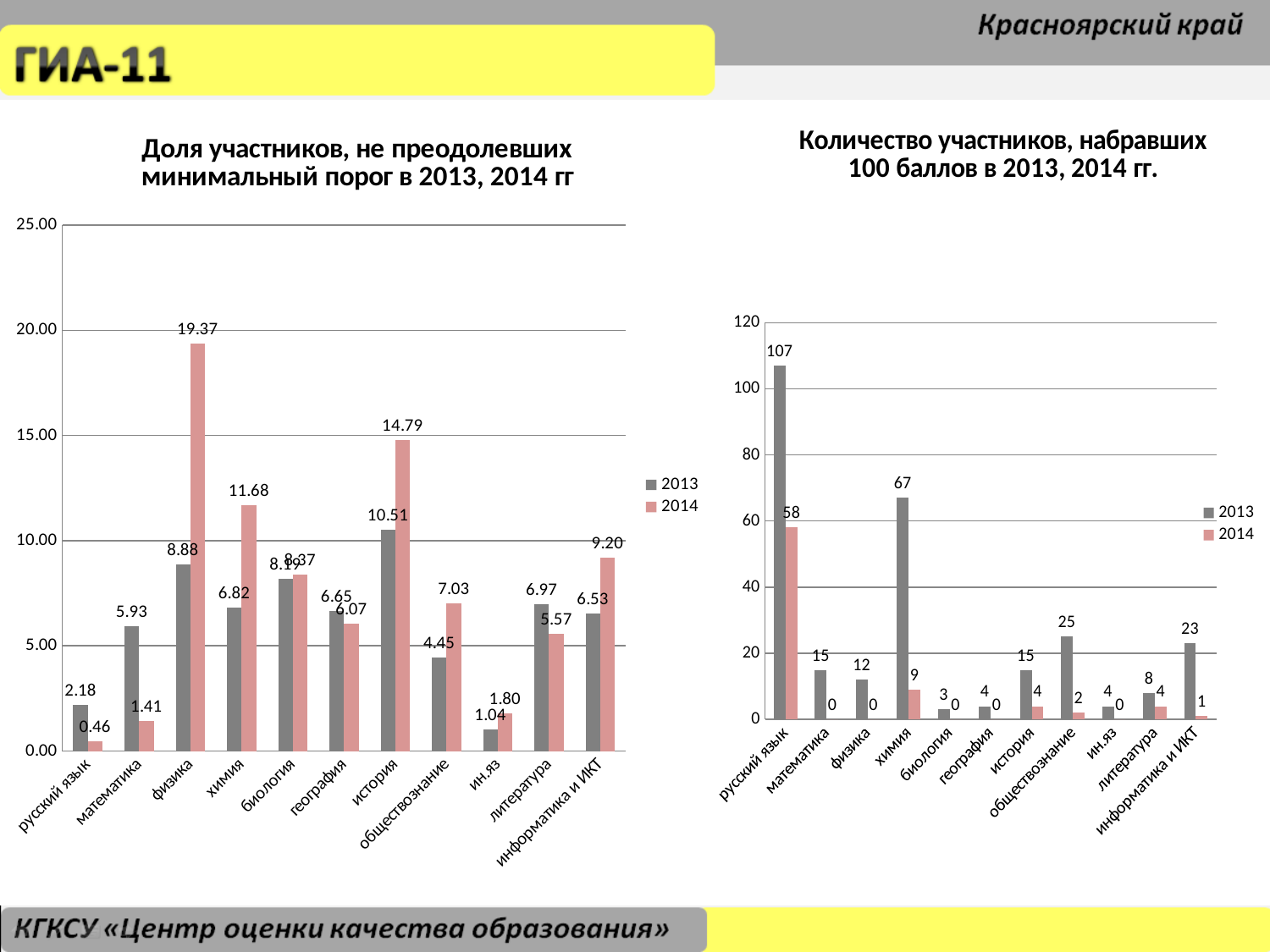
In the chart 'Доля участников, не преодолевших минимальный порог в 2013, 2014 гг', which subject has the highest 2014 value? физика What type of chart is the chart on the right of the slide? bar chart In the chart 'Доля участников, не преодолевших минимальный порог в 2013, 2014 гг', what is the difference between the 2014 and 2013 values for химия? 4.86 In the chart 'Доля участников, не преодолевших минимальный порог в 2013, 2014 гг', which subject has the lowest 2014 value? русский язык In the chart 'Доля участников, не преодолевших минимальный порог в 2013, 2014 гг', which is larger for литература: the 2013 value or the 2014 value? 2013 How many series does the legend list in the chart 'Количество участников, набравших 100 баллов в 2013, 2014 гг.'? 2 In the chart 'Количество участников, набравших 100 баллов в 2013, 2014 гг.', what is the 2014 value for химия? 9 In the chart 'Доля участников, не преодолевших минимальный порог в 2013, 2014 гг', what is the value for история in 2013? 10.51 How many subjects are shown on the x axis of the chart 'Доля участников, не преодолевших минимальный порог в 2013, 2014 гг'? 11 In the chart 'Количество участников, набравших 100 баллов в 2013, 2014 гг.', how many participants scored 100 in русский язык in 2013? 107 In the chart 'Доля участников, не преодолевших минимальный порог в 2013, 2014 гг', what is the value for физика in 2014? 19.37 In the chart 'Количество участников, набравших 100 баллов в 2013, 2014 гг.', what is the difference between the 2013 and 2014 values for русский язык? 49